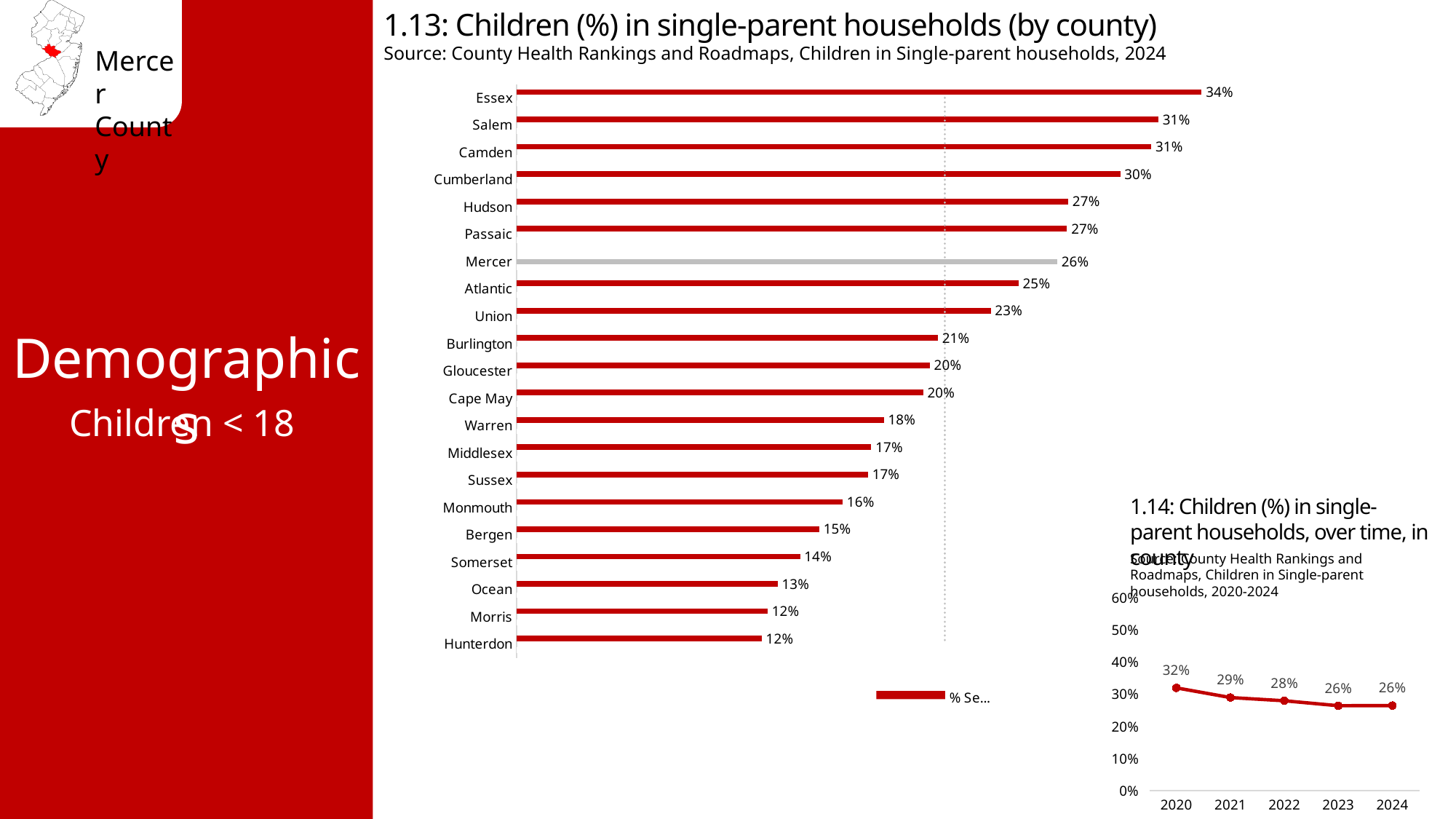
In chart 1.14 (over time), do the values rise or fall from 2020 to 2024? Fall In chart 1.13 (by county), what is the value for Cumberland? 30% In chart 1.13 (by county), what is the value for Hunterdon? 12% In chart 1.14 (over time), what is the difference between the 2020 value and the 2024 value? 6 percentage points In chart 1.13 (by county), what is the difference between Essex and Mercer? 8 percentage points In chart 1.13 (by county), which county has the highest percentage of children in single-parent households? Essex In chart 1.14 (over time), how many years are plotted? 5 In chart 1.13 (by county), which is larger, the value for Hudson or the value for Union? Hudson In chart 1.13 (by county), how many counties are shown? 21 In chart 1.14 (Children (%) in single-parent households over time), what is the value for 2020? 32% In chart 1.13 (Children (%) in single-parent households by county), what is the value for Mercer? 26% What kind of chart is chart 1.13 (Children (%) in single-parent households by county)? Bar chart